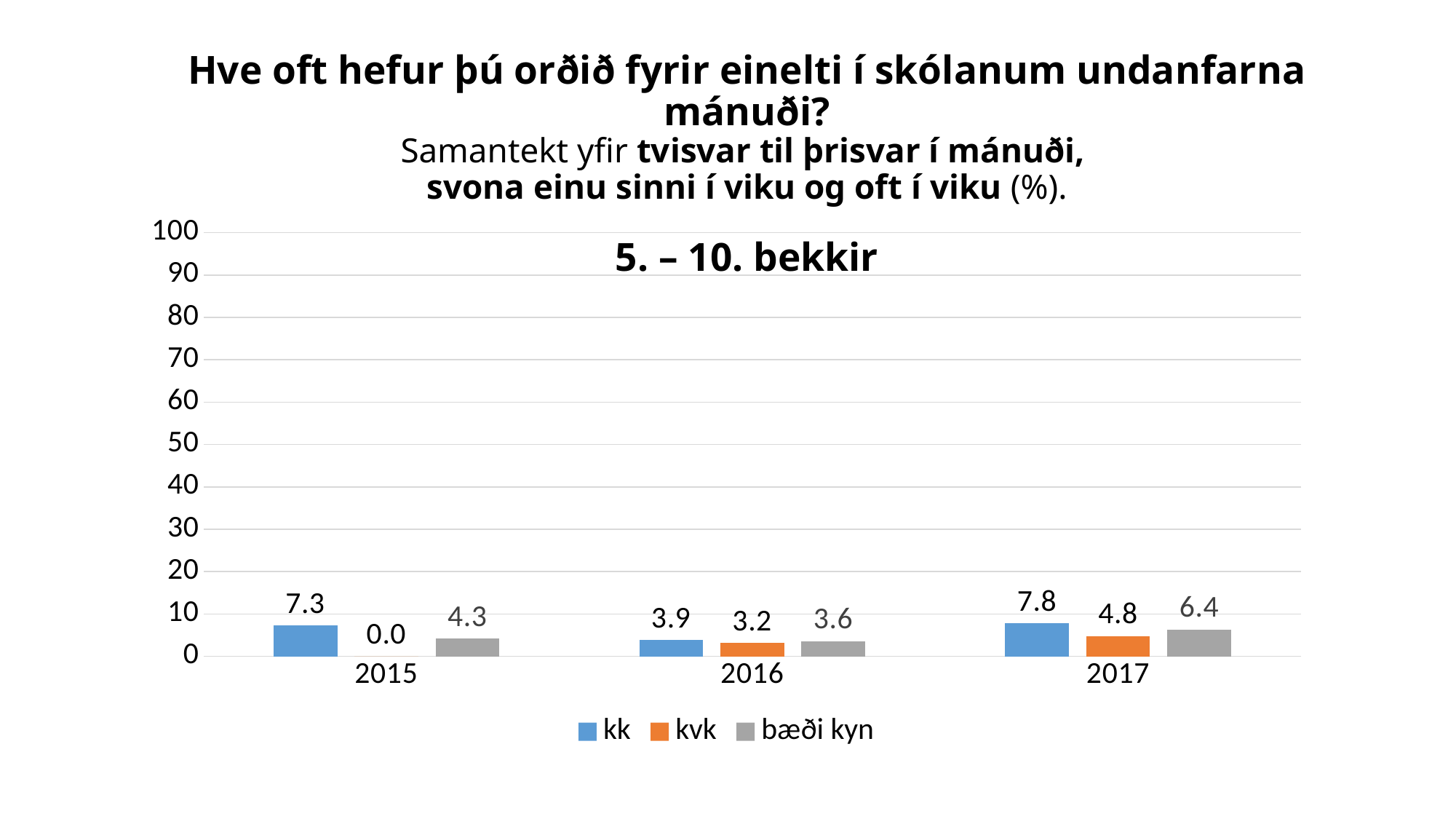
Which is larger, the kvk value in 2017 or the kvk value in 2016? kvk in 2017 Is the value for kk in 2017 greater or less than 10? less What is the difference between the kk value in 2017 and the kk value in 2016? 3.9 What is the value for bæði kyn in 2017? 6.4 What is the value for kvk in 2015? 0.0 What is the value for kk in 2015? 7.3 How many years are shown on the x axis? 3 How many series does the legend list? 3 In which year is the bæði kyn value lowest? 2016 What kind of chart is shown on the slide? bar chart What is the value for kvk in 2016? 3.2 In which year is the kk value highest? 2017